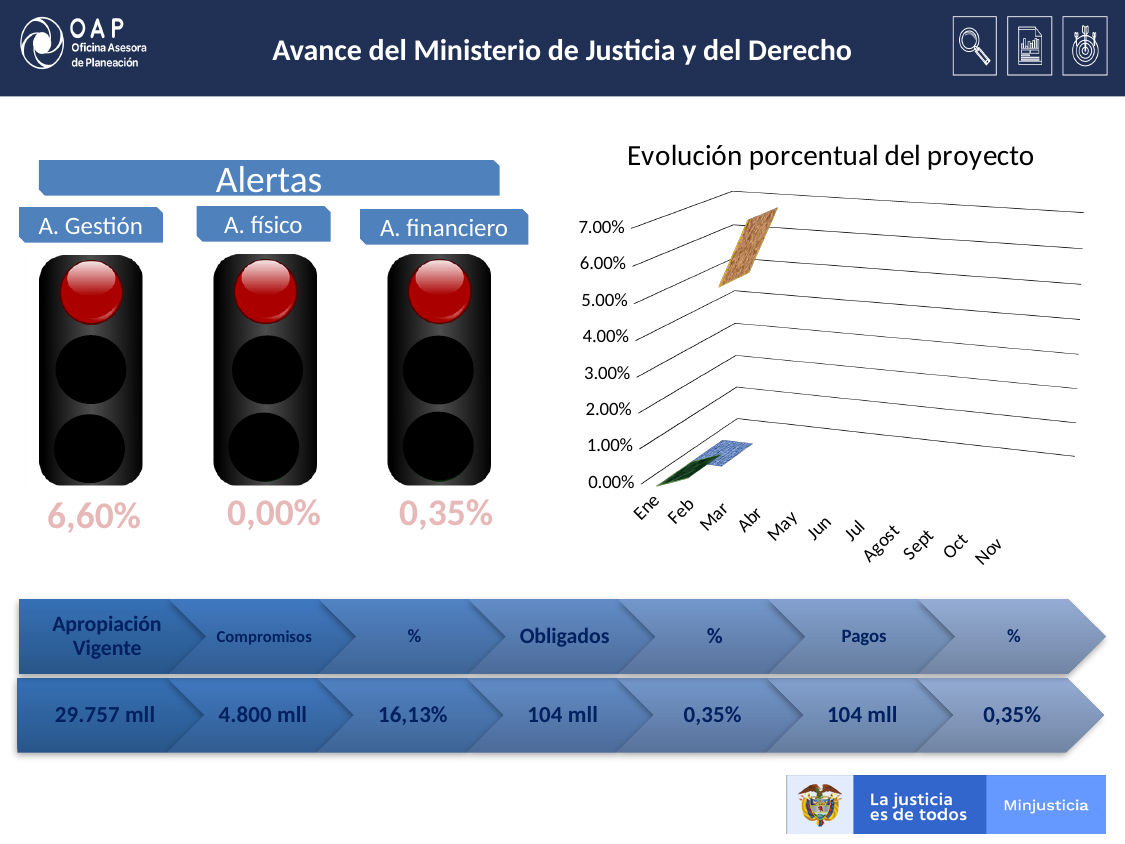
What kind of chart is 'Evolución porcentual del proyecto'? 3D line chart In the 'Evolución porcentual del proyecto' chart, is the lowest plotted series greater or less than 2.00%? less In the 'Evolución porcentual del proyecto' chart, is the highest plotted value greater or less than 4.00%? greater How many months are shown on the x axis of the 'Evolución porcentual del proyecto' chart? 11 What is the highest value shown on the y axis of the 'Evolución porcentual del proyecto' chart? 7.00% What is the title of the chart on the slide? Evolución porcentual del proyecto What is the first category on the x axis of the 'Evolución porcentual del proyecto' chart? Ene What is the last category on the x axis of the 'Evolución porcentual del proyecto' chart? Nov